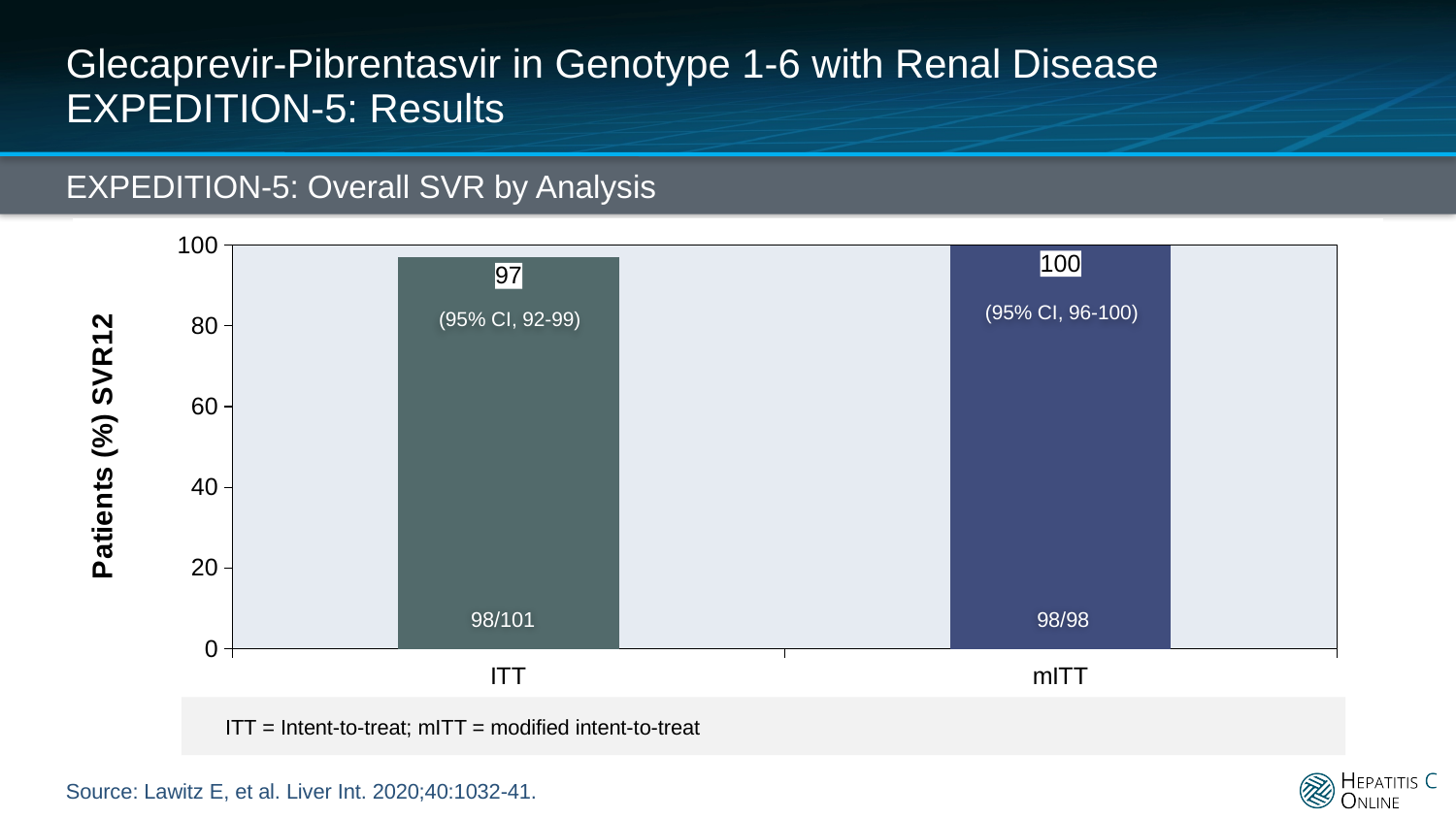
What fraction of patients is shown for the ITT bar? 98/101 What is the difference in SVR12 between the mITT and ITT analyses? 3 What is the SVR12 value for the mITT analysis? 100 What is the 95% confidence interval shown for the ITT analysis? 92-99 Is the SVR12 value for ITT greater or less than 80? greater Which analysis has the lower SVR12 value? ITT What is the SVR12 value for the ITT analysis? 97 What kind of chart is shown on the slide? Bar chart What is the 95% confidence interval shown for the mITT analysis? 96-100 How many categories are shown on the x axis? 2 What is the label of the y axis? Patients (%) SVR12 Which analysis has the higher SVR12 value? mITT